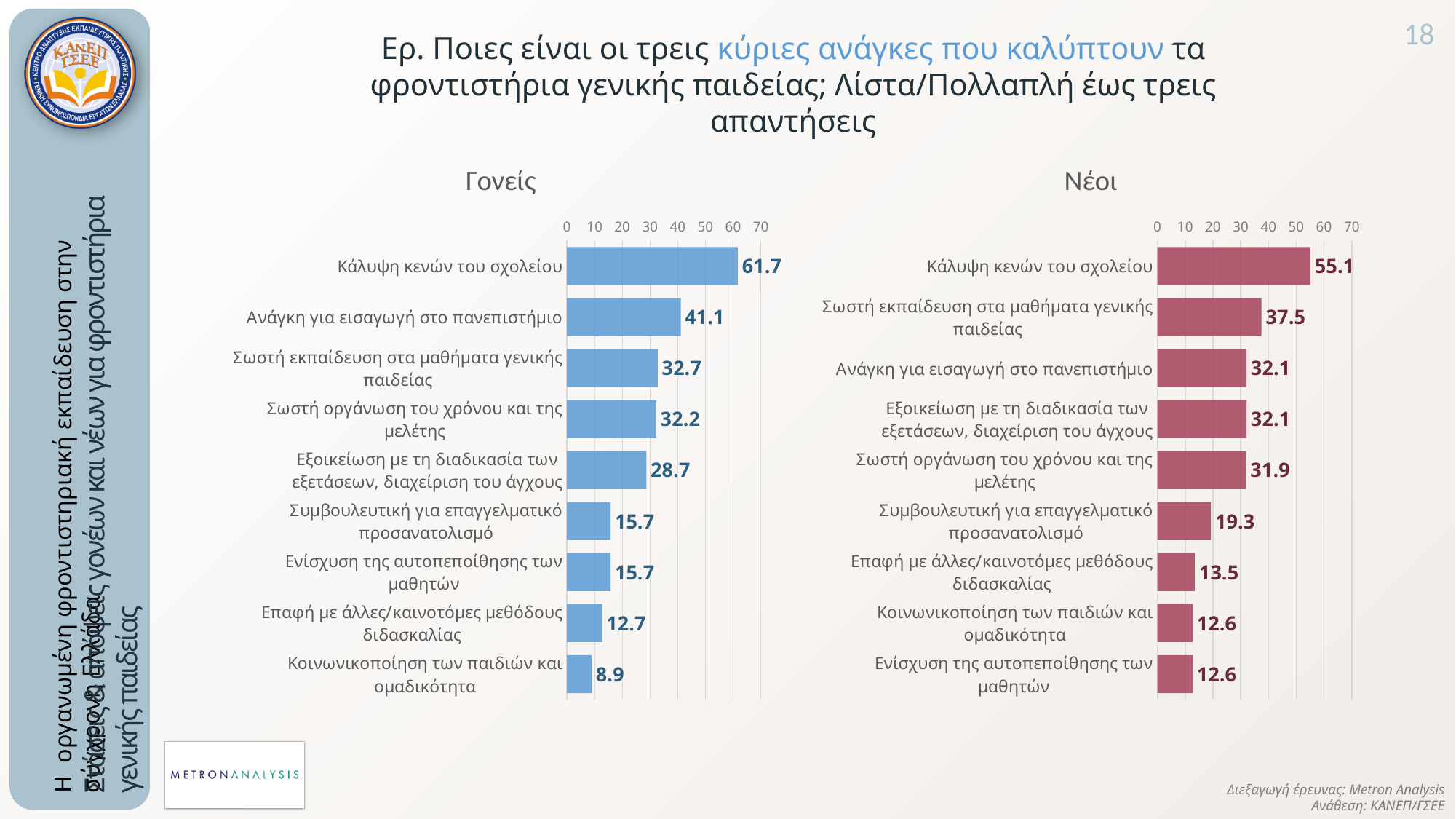
In the Γονείς chart, which category has the lowest value? Κοινωνικοποίηση των παιδιών και ομαδικότητα In the Γονείς chart, what is the value for Κάλυψη κενών του σχολείου? 61.7 In the Νέοι chart, what is the value for Σωστή εκπαίδευση στα μαθήματα γενικής παιδείας? 37.5 In the Νέοι chart, which category has the highest value? Κάλυψη κενών του σχολείου What type of chart is the Γονείς chart? Bar chart In the Νέοι chart, what is the value for Συμβουλευτική για επαγγελματικό προσανατολισμό? 19.3 What is the difference between the value for Κάλυψη κενών του σχολείου in the Γονείς chart and in the Νέοι chart? 6.6 How many categories are shown in the Νέοι chart? 9 Which is larger: Ανάγκη για εισαγωγή στο πανεπιστήμιο in the Γονείς chart or in the Νέοι chart? Γονείς In the Γονείς chart, what is the value for Ανάγκη για εισαγωγή στο πανεπιστήμιο? 41.1 What colour are the bars in the Νέοι chart? Red In the Γονείς chart, what is the difference between Ανάγκη για εισαγωγή στο πανεπιστήμιο and Σωστή εκπαίδευση στα μαθήματα γενικής παιδείας? 8.4